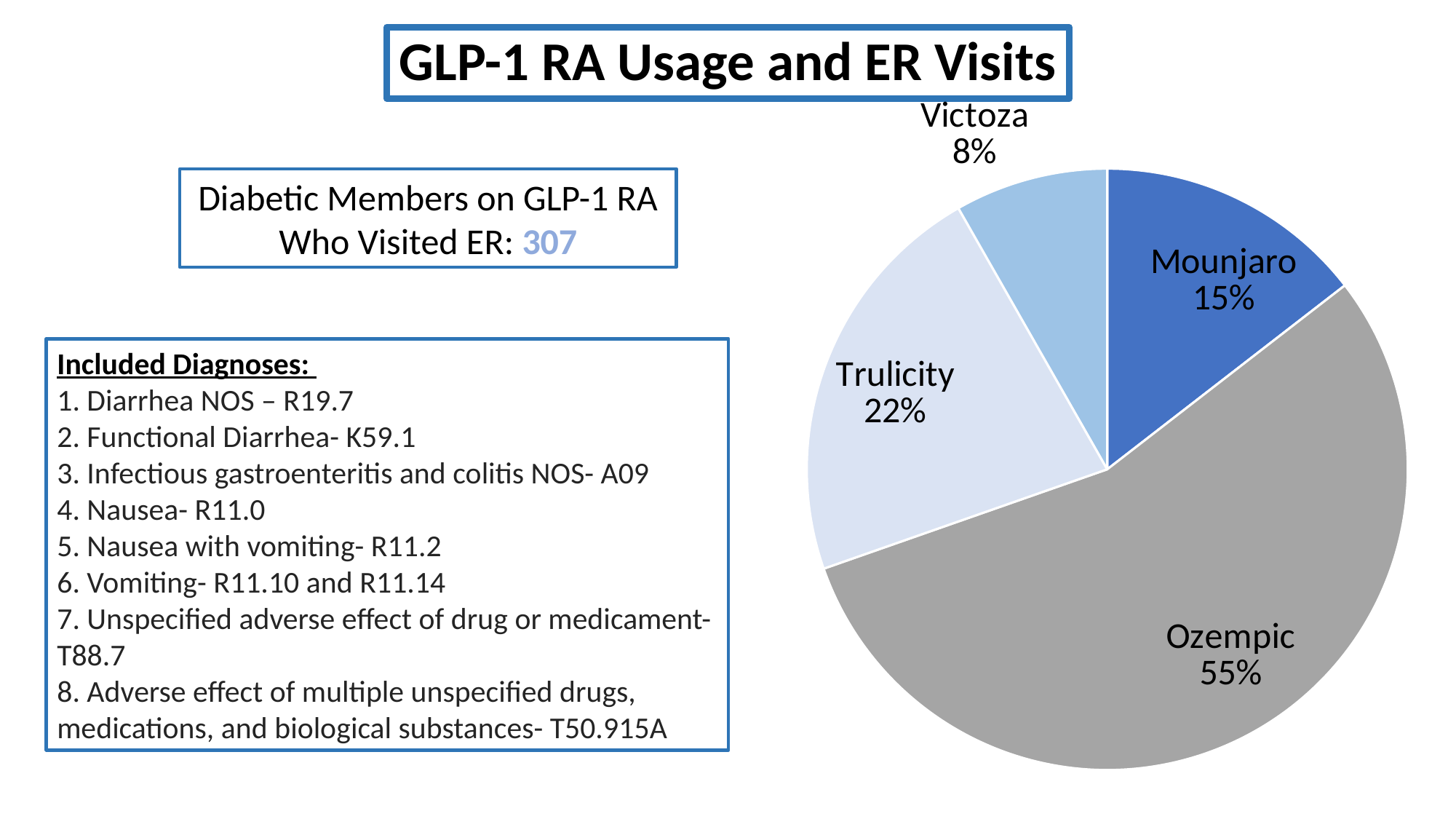
What percentage is shown for Trulicity? 22% Which medication has the largest slice of the pie? Ozempic What percentage is shown for Victoza? 8% What is the difference in percentage points between Mounjaro and Victoza? 7 Which medication has the smallest slice of the pie? Victoza Which is larger, the share for Trulicity or the share for Mounjaro? Trulicity What kind of chart is shown on the slide? Pie chart How many slices does the pie chart have? 4 What is the difference in percentage points between Ozempic and Trulicity? 33 What percentage is shown for Mounjaro? 15% What share of the pie does Ozempic account for? 55% What colour is the Ozempic slice of the pie? Grey